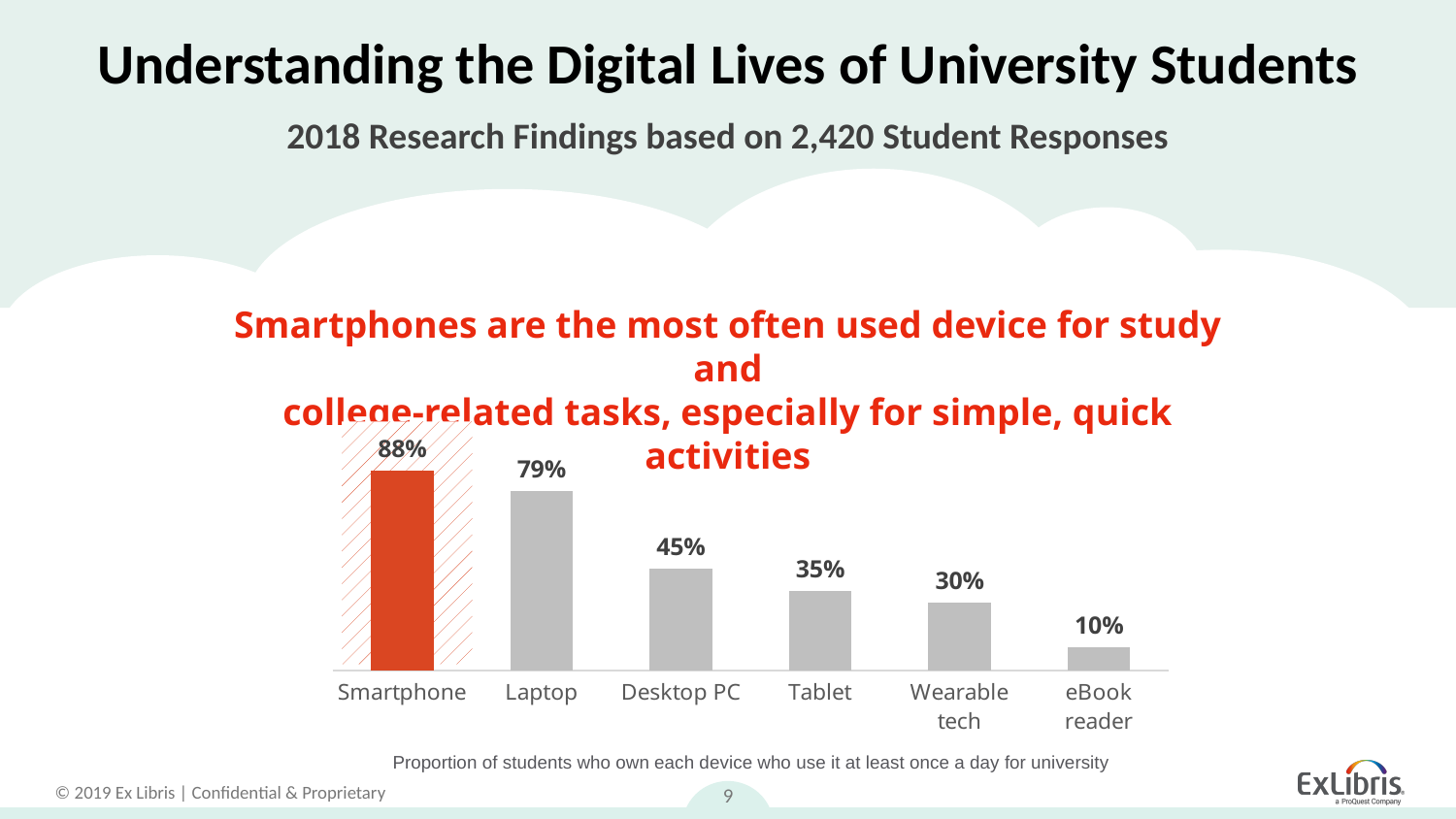
What is the difference between the values for Smartphone and Laptop? 9% What is the difference between the values for Tablet and eBook reader? 25% What is the value for Laptop? 79% What is the value for Desktop PC? 45% Which is larger, the value for Desktop PC or the value for Tablet? Desktop PC Which device has the lowest value? eBook reader How many devices are shown in the chart? 6 What is the value for Wearable tech? 30% What kind of chart is shown on the slide? Bar chart Which bar is highlighted in a different colour from the others? Smartphone Which device has the highest value? Smartphone What is the value for Smartphone? 88%